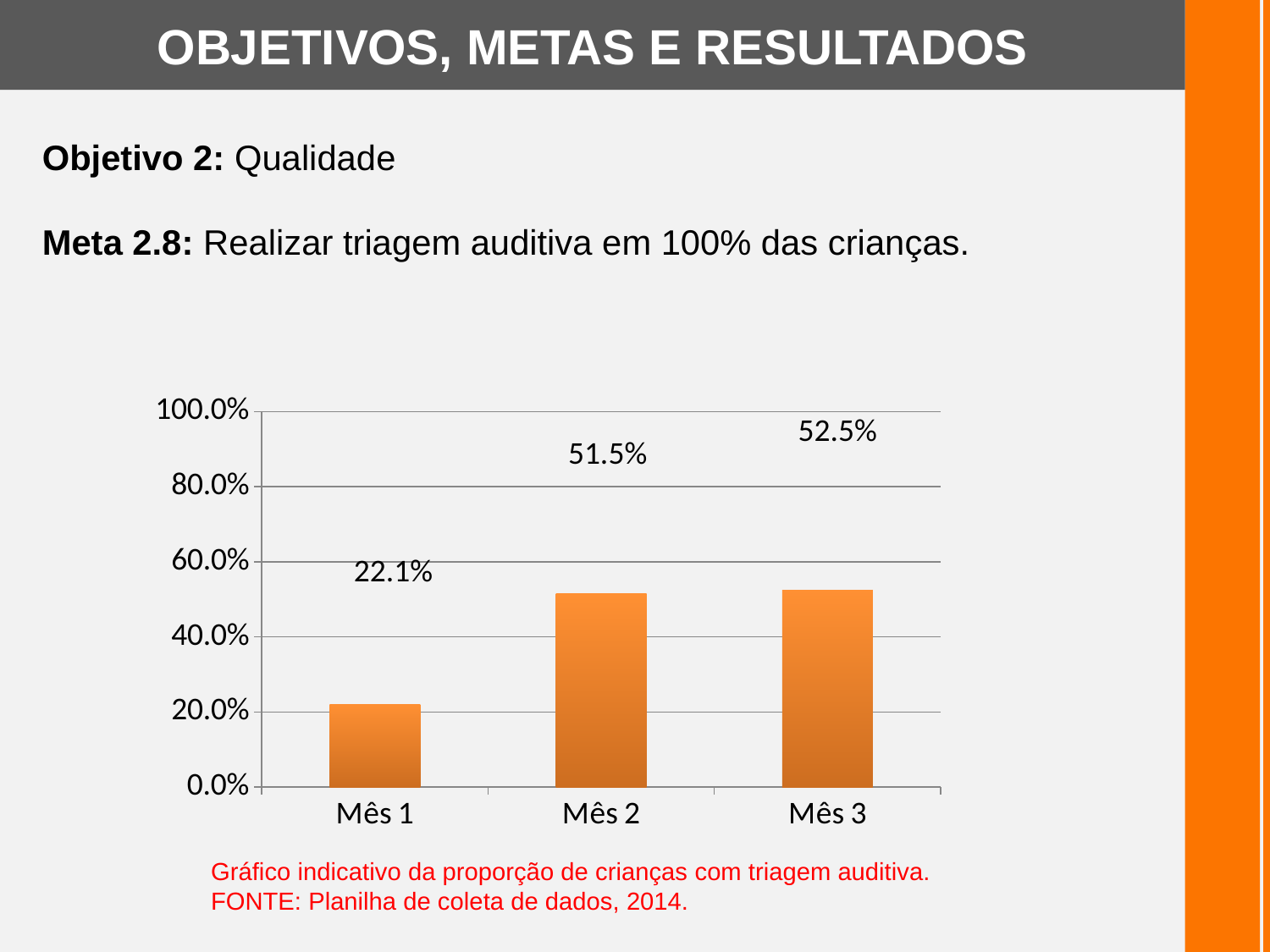
What kind of chart is shown on the slide? bar chart Is the value for Mês 1 greater or less than 40.0%? less What is the difference between the values for Mês 2 and Mês 1? 29.4% How many months are shown on the x axis? 3 What is the value for Mês 3? 52.5% What is the difference between the values for Mês 3 and Mês 2? 1.0% What is the value for Mês 2? 51.5% Do the values rise or fall from Mês 1 to Mês 3? rise What is the value for Mês 1? 22.1% Which is larger, the value for Mês 1 or the value for Mês 2? Mês 2 Which month has the lowest value? Mês 1 Which month has the highest value? Mês 3